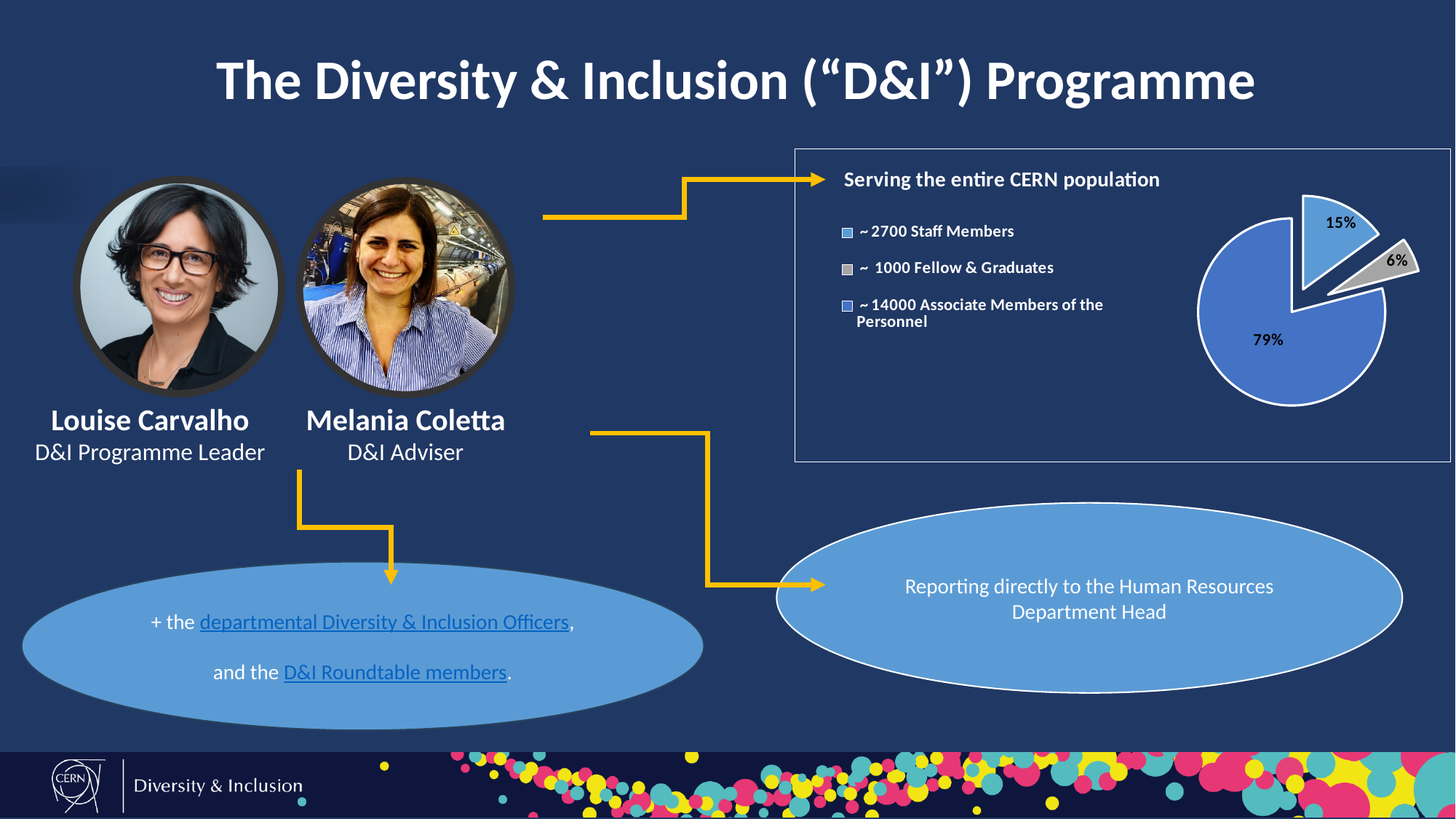
How many slices does the pie chart have? 3 What share of the pie chart is labelled for Fellow & Graduates? 6% What approximate number of Associate Members of the Personnel does the legend give? ~ 14000 What share of the pie chart is labelled for Associate Members of the Personnel? 79% How many entries does the legend of the pie chart list? 3 What kind of chart is shown in the 'Serving the entire CERN population' box? pie chart What colour is the Fellow & Graduates slice in the pie chart? grey Which category has the largest slice of the pie chart? Associate Members of the Personnel What is the difference in percentage points between the Associate Members of the Personnel slice and the Staff Members slice? 64 Which category has the smallest slice of the pie chart? Fellow & Graduates Which slice is larger, Staff Members or Fellow & Graduates? Staff Members What share of the pie chart is labelled for Staff Members? 15%